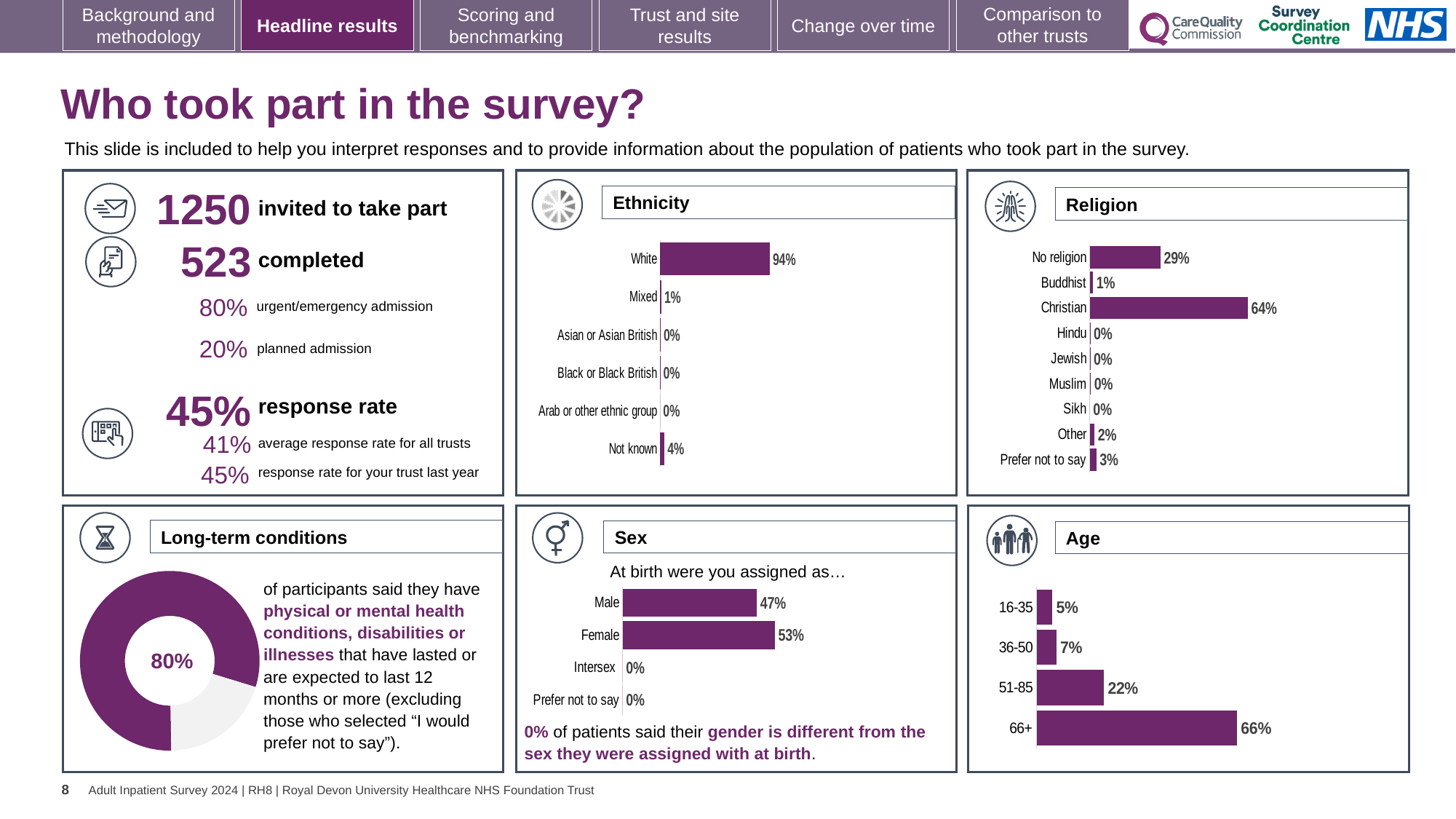
In the Age chart, which age group has the lowest value? 16-35 In the Sex chart, what is the value for Male? 47% What kind of chart is used in the Long-term conditions panel? donut chart In the Religion chart, what is the value for Christian? 64% In the Age chart, do the values rise or fall as age increases from 16-35 to 66+? rise In the Ethnicity chart, which category has the highest value? White In the Ethnicity chart, what percentage of respondents were White? 94% In the Sex chart, which is larger, Male or Female? Female In the Ethnicity chart, how many categories are shown? 6 In the Religion chart, how many categories are listed? 9 In the Religion chart, what is the difference between the Christian and No religion values? 35% In the Age chart, what is the value for the 51-85 group? 22%